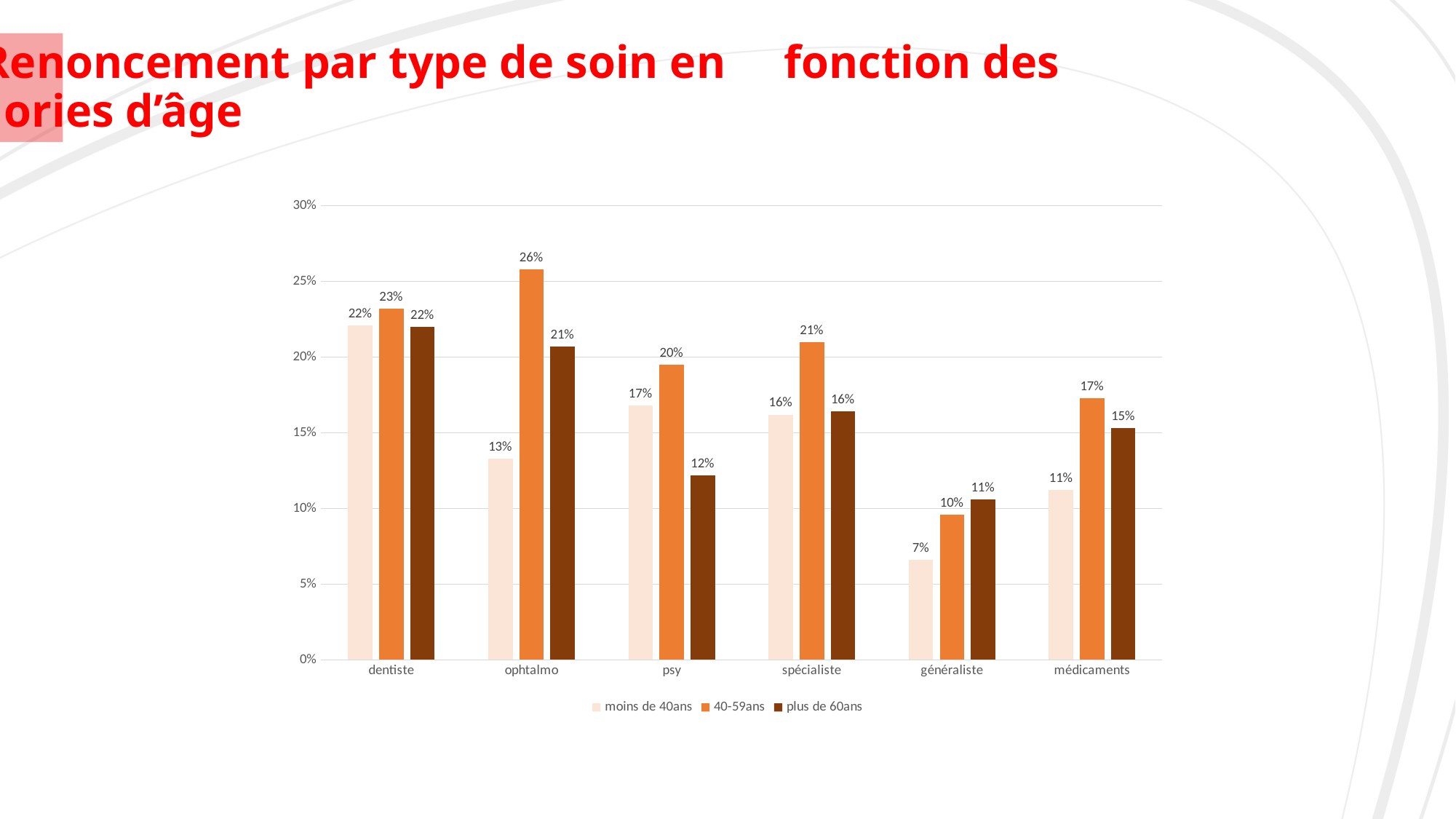
How many series does the legend list? 3 Which is larger for psy: the 40-59ans value or the plus de 60ans value? 40-59ans How many categories are shown on the x axis? 6 What is the value for ophtalmo in the 40-59ans series? 26% Which category has the highest value in the 40-59ans series? ophtalmo What are the three series listed in the legend? moins de 40ans, 40-59ans, plus de 60ans Is the value for dentiste in the moins de 40ans series greater or less than 20%? greater What is the value for médicaments in the plus de 60ans series? 15% What kind of chart is shown on the slide? bar chart What is the difference between the 40-59ans and moins de 40ans values for ophtalmo? 13% What is the value for généraliste in the moins de 40ans series? 7% Which category has the lowest value in the moins de 40ans series? généraliste